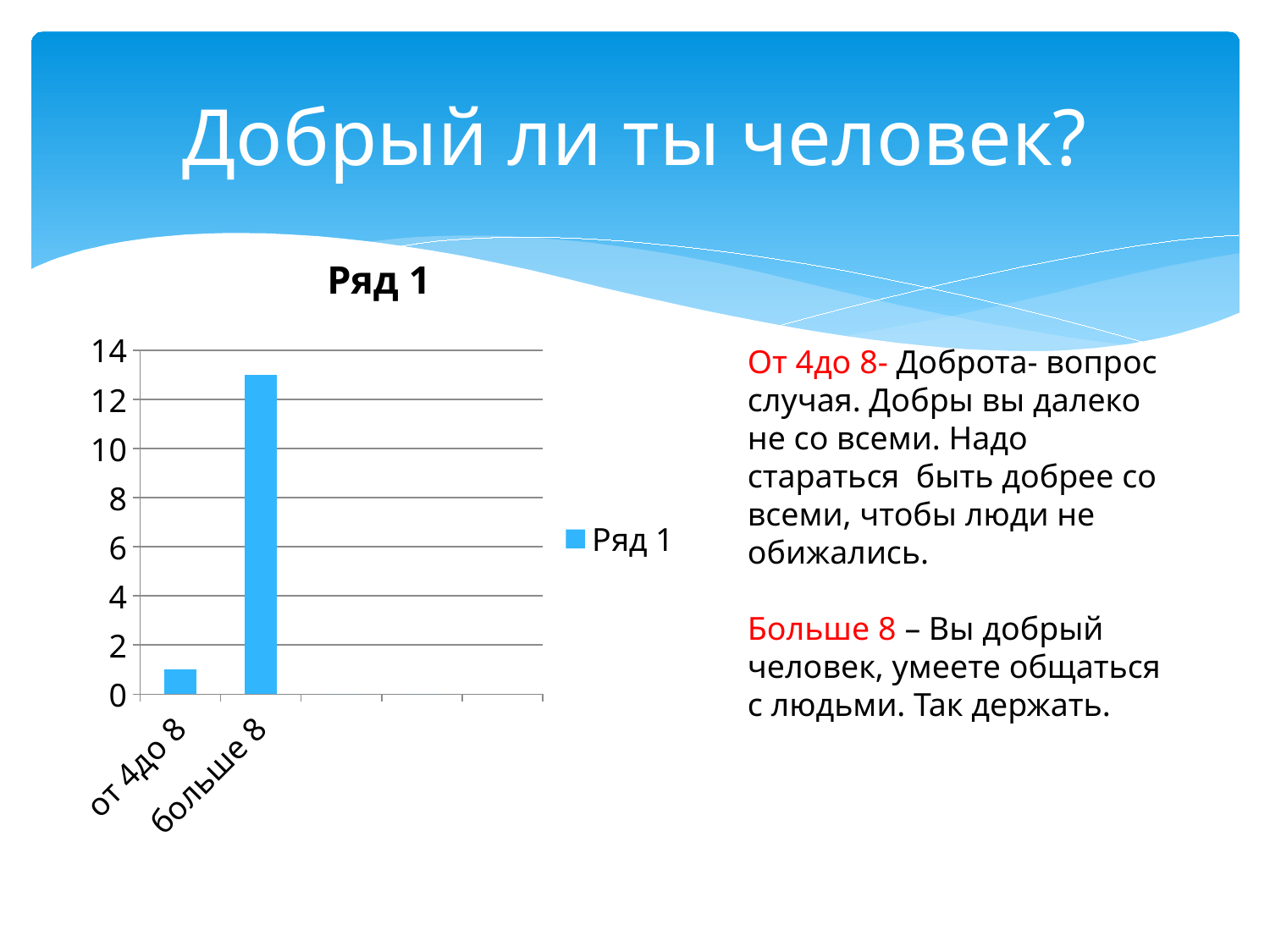
What is the title of the chart? Ряд 1 Do the bar values rise or fall from "от 4до 8" to "больше 8"? rise How many bars are plotted in the chart? 2 What kind of chart is shown on the slide? bar chart How many series does the chart legend list? 1 What is the name of the series shown in the legend? Ряд 1 Is the value for "от 4до 8" greater or less than 2? less Is the value for "больше 8" greater or less than 14? less Which is larger, the value for "от 4до 8" or the value for "больше 8"? больше 8 Which category has the highest bar? больше 8 Is the value for "больше 8" greater or less than 12? greater Which category has the lowest bar? от 4до 8